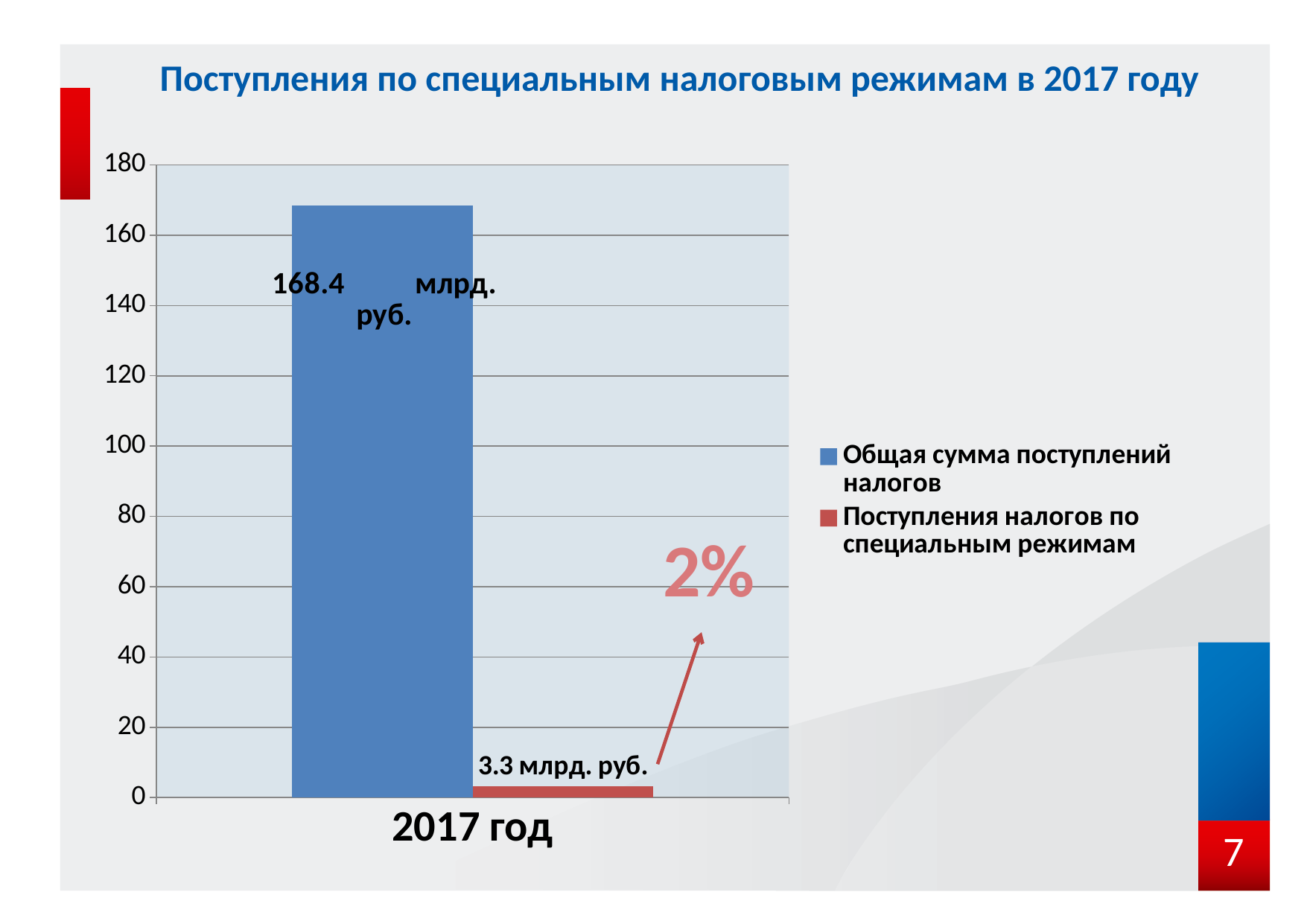
Which series has the lower value in 2017 год? Поступления налогов по специальным режимам What is the title of the chart? Поступления по специальным налоговым режимам в 2017 году Is the value for 'Поступления налогов по специальным режимам' greater or less than 20? less What is the difference between the total tax receipts (168.4) and the receipts under special tax regimes (3.3) in 2017 год? 165.1 млрд. руб. What percentage is shown next to the arrow pointing at the red bar? 2% Is the value for 'Общая сумма поступлений налогов' greater or less than 160? greater What kind of chart is shown on the slide? Bar chart How many categories are shown on the x axis? 1 What is the value of the 'Поступления налогов по специальным режимам' bar for 2017 год? 3.3 млрд. руб. What is the value of the 'Общая сумма поступлений налогов' bar for 2017 год? 168.4 млрд. руб. How many series does the legend list? 2 Which series has the higher value in 2017 год? Общая сумма поступлений налогов